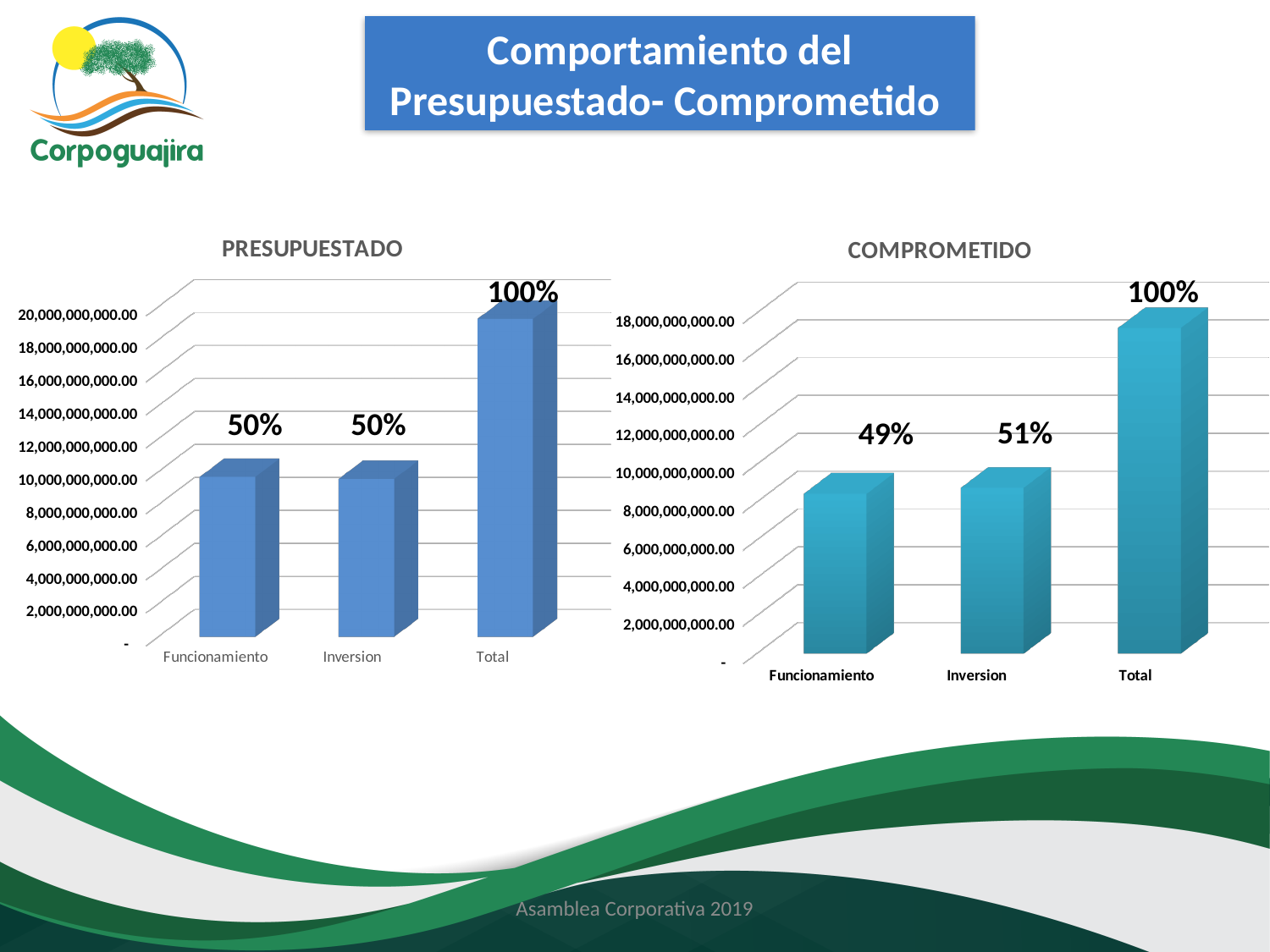
In the PRESUPUESTADO chart, how many categories are shown on the x axis? 3 What kind of chart is the COMPROMETIDO chart? Bar chart In the PRESUPUESTADO chart, what is the data label shown for Funcionamiento? 50% In the PRESUPUESTADO chart, which is larger, the bar for Total or the bar for Inversion? Total What is the title of the chart on the right side of the slide? COMPROMETIDO In the COMPROMETIDO chart, what is the data label shown for Inversion? 51% In the COMPROMETIDO chart, which category has the highest bar? Total In the PRESUPUESTADO chart, what is the data label shown for Total? 100% In the COMPROMETIDO chart, what is the data label shown for Funcionamiento? 49% In the COMPROMETIDO chart, which category has the lowest bar? Funcionamiento In the COMPROMETIDO chart, is the value for Funcionamiento greater or less than 12,000,000,000.00? less In the PRESUPUESTADO chart, is the value for Total greater or less than 18,000,000,000.00? greater